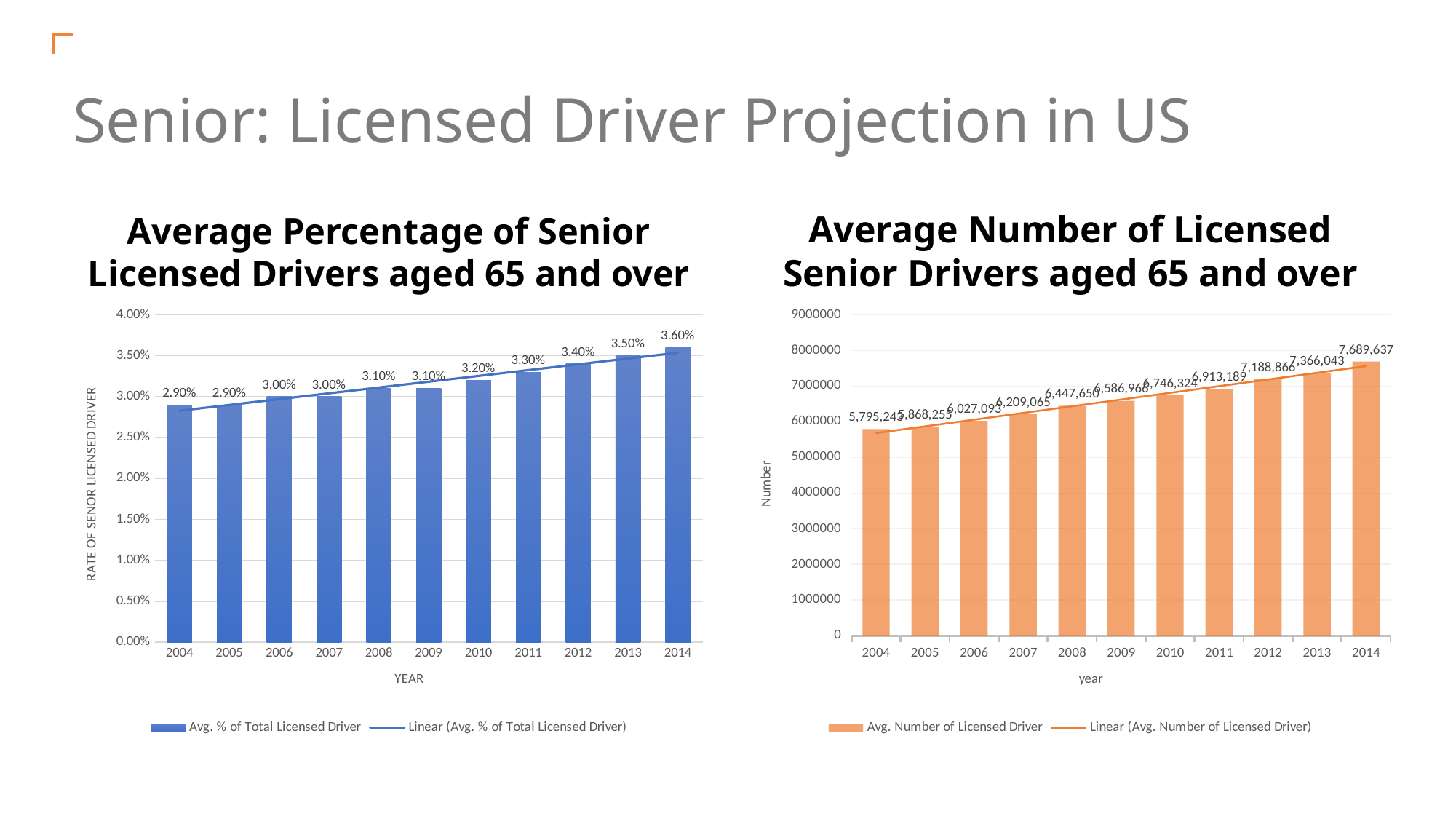
On the right chart (Average Number of Licensed Senior Drivers aged 65 and over), what is the value for 2014? 7,689,637 On the right chart (Average Number of Licensed Senior Drivers aged 65 and over), what is the value for 2012? 7,188,866 What kind of chart is the right chart (Average Number of Licensed Senior Drivers aged 65 and over)? bar chart On the left chart (Average Percentage of Senior Licensed Drivers aged 65 and over), how many years are shown on the x axis? 11 On the left chart (Average Percentage of Senior Licensed Drivers aged 65 and over), what is the difference between the 2014 and 2004 values? 0.70% On the left chart (Average Percentage of Senior Licensed Drivers aged 65 and over), which year has the highest value? 2014 On the right chart (Average Number of Licensed Senior Drivers aged 65 and over), is the value for 2004 greater or less than 6000000? less On the left chart (Average Percentage of Senior Licensed Drivers aged 65 and over), do the values rise or fall from 2004 to 2014? rise On the right chart (Average Number of Licensed Senior Drivers aged 65 and over), which year has the lowest value? 2004 On the left chart (Average Percentage of Senior Licensed Drivers aged 65 and over), what is the value for 2008? 3.10% On the right chart (Average Number of Licensed Senior Drivers aged 65 and over), which is larger, the value for 2010 or the value for 2013? 2013 On the left chart (Average Percentage of Senior Licensed Drivers aged 65 and over), what is the value for 2014? 3.60%